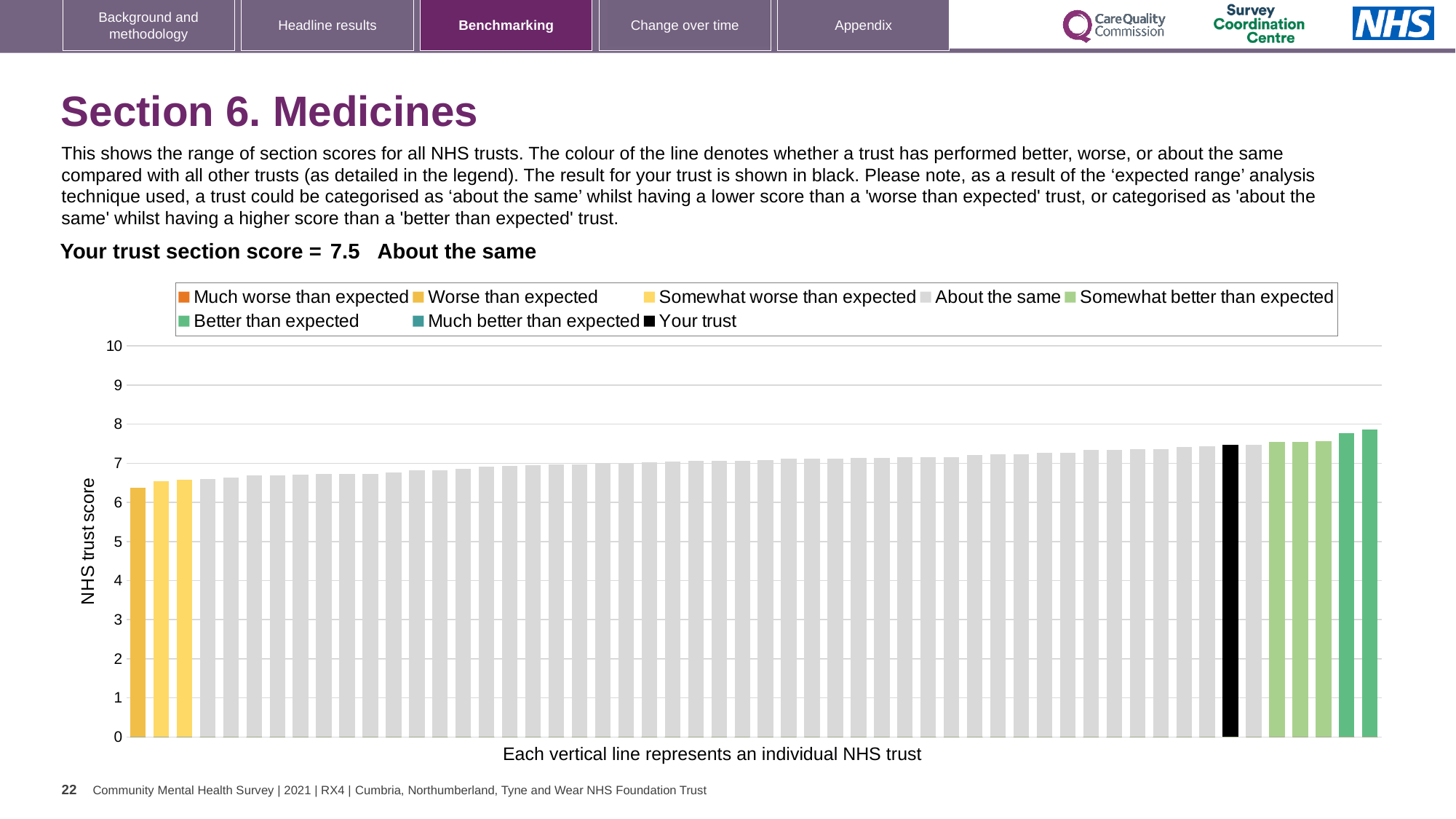
What is the section score for your trust shown on the slide? 7.5 How many entries does the chart legend list? 8 Which category is your trust placed in for the Medicines section? About the same Is the value of the black bar (your trust) greater or less than 7? greater What is the label on the vertical axis of the chart? NHS trust score How many bars are coloured as 'Much better than expected'? 0 Is the value of the highest bar on the chart greater or less than 8? less What kind of chart is shown on the slide? bar chart Do the bar values rise or fall from left to right along the x axis? rise Is the value of the lowest bar on the chart greater or less than 7? less What colour is used for the bar representing your trust? black Which legend category does the tallest bar on the chart belong to? Better than expected